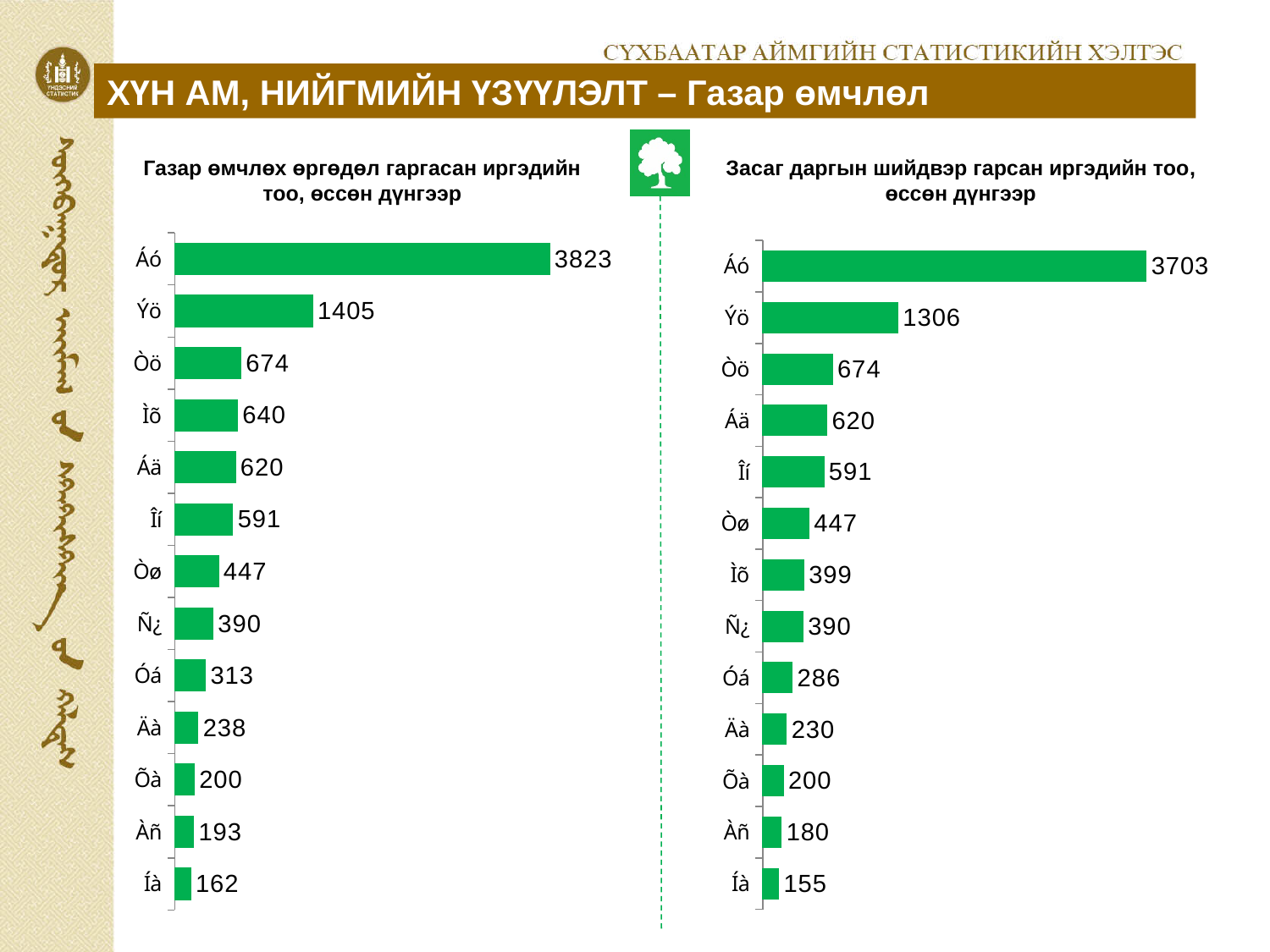
In the left chart (Газар өмчлөх өргөдөл гаргасан иргэдийн тоо), what is the value for the category labelled Ýö? 1405 In the left chart, which category has the highest value? Áó In the left chart, is the value for Òø greater or less than 400? greater What type of chart is the left chart? Bar chart How many categories are shown in the right chart? 13 In the right chart (Засаг даргын шийдвэр гарсан иргэдийн тоо), what is the value for the category labelled Ìõ? 399 What is the title of the right chart? Засаг даргын шийдвэр гарсан иргэдийн тоо, өссөн дүнгээр In the right chart, which category has the lowest value? Íà Which is larger: the value for Áó in the left chart or the value for Áó in the right chart? Left chart (3823) In the right chart, do the values increase or decrease going from the top bar to the bottom bar? Decrease In the left chart, what is the difference between the values for Áó and Ýö? 2418 In the right chart, what is the difference between the values for Òö and Áä? 54